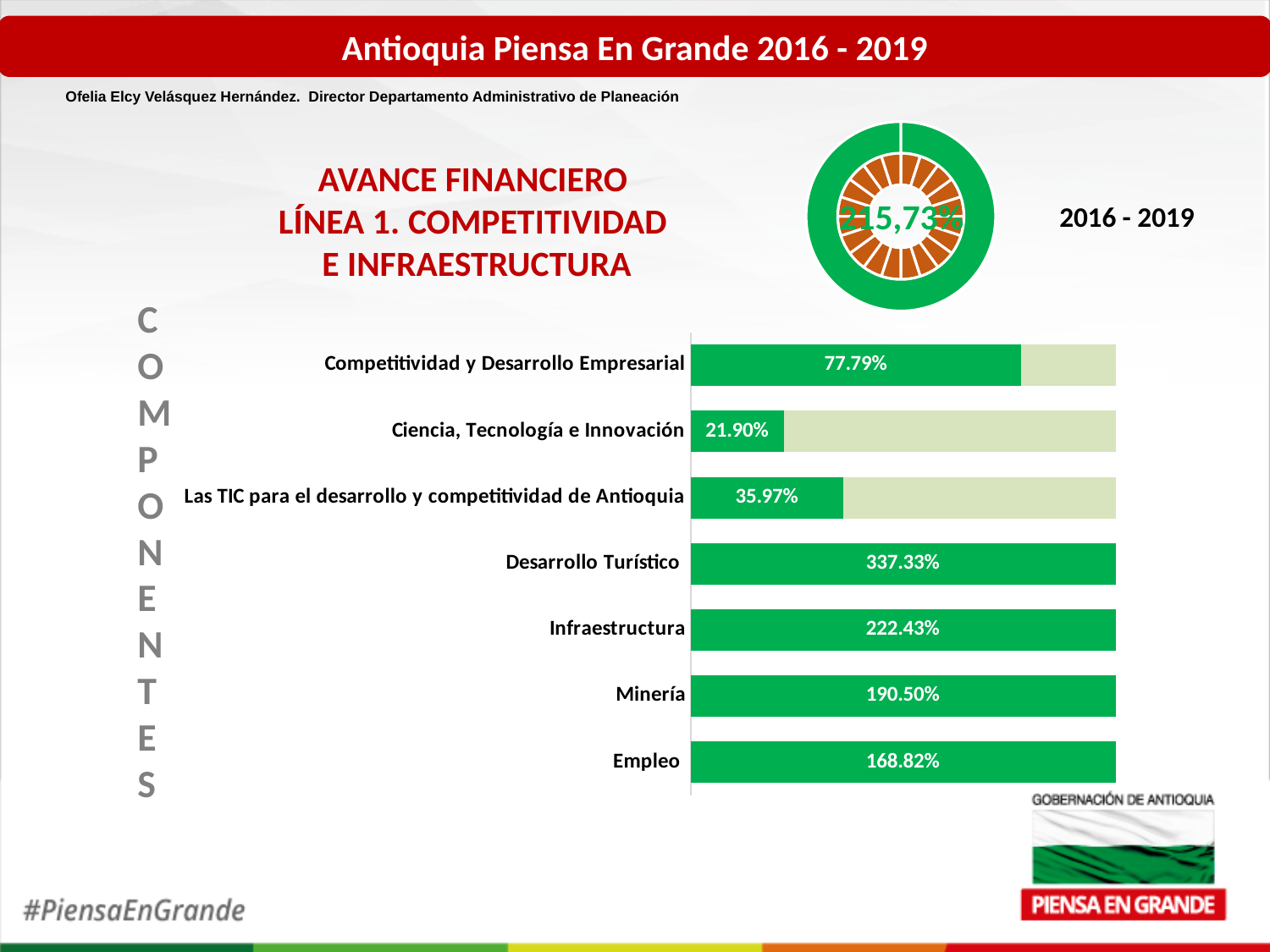
What kind of chart is used to show the components? Bar chart In the bar chart, what is the value for Infraestructura? 222.43% How many components are shown in the bar chart? 7 In the bar chart, which is larger: the value for Minería or the value for Empleo? Minería In the bar chart, what is the value for Empleo? 168.82% In the bar chart, what is the difference between the values for Infraestructura and Minería? 31.93% In the bar chart, which component has the highest value? Desarrollo Turístico In the bar chart, what is the value for Desarrollo Turístico? 337.33% In the bar chart, what is the difference between the values for Competitividad y Desarrollo Empresarial and Las TIC para el desarrollo y competitividad de Antioquia? 41.82% What percentage is shown in the centre of the donut chart at the top of the slide? 215,73% In the bar chart, what is the value for Ciencia, Tecnología e Innovación? 21.90% In the bar chart, which component has the lowest value? Ciencia, Tecnología e Innovación